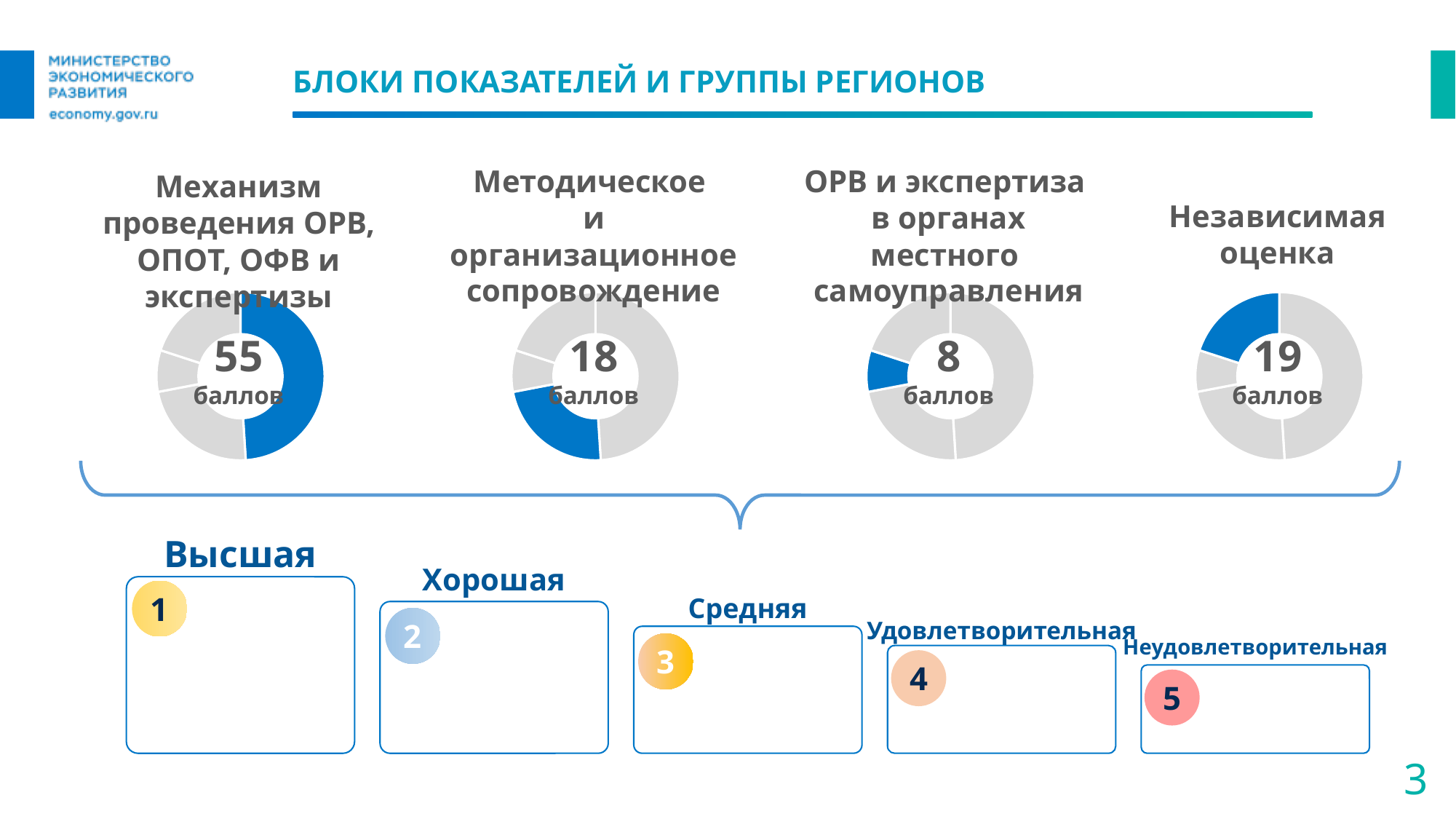
In the donut chart titled "Независимая оценка", what value is shown in the centre? 19 баллов In the donut chart titled "Механизм проведения ОРВ, ОПОТ, ОФВ и экспертизы", what value is shown in the centre? 55 баллов In the donut chart titled "Методическое и организационное сопровождение", what value is shown in the centre? 18 баллов What is the sum of the баллов shown in the four donut charts? 100 Across the four donut charts, which block has the highest number of баллов? Механизм проведения ОРВ, ОПОТ, ОФВ и экспертизы Which has more баллов: the "Независимая оценка" chart or the "Методическое и организационное сопровождение" chart? Независимая оценка In the donut chart titled "ОРВ и экспертиза в органах местного самоуправления", what value is shown in the centre? 8 баллов What colour is the filled segment in each donut chart? Blue What is the difference in баллов between the "Механизм проведения ОРВ, ОПОТ, ОФВ и экспертизы" chart and the "Независимая оценка" chart? 36 Across the four donut charts, which block has the lowest number of баллов? ОРВ и экспертиза в органах местного самоуправления What kind of chart is used to show the баллов for each block? Donut chart How many donut charts are shown on the slide? 4